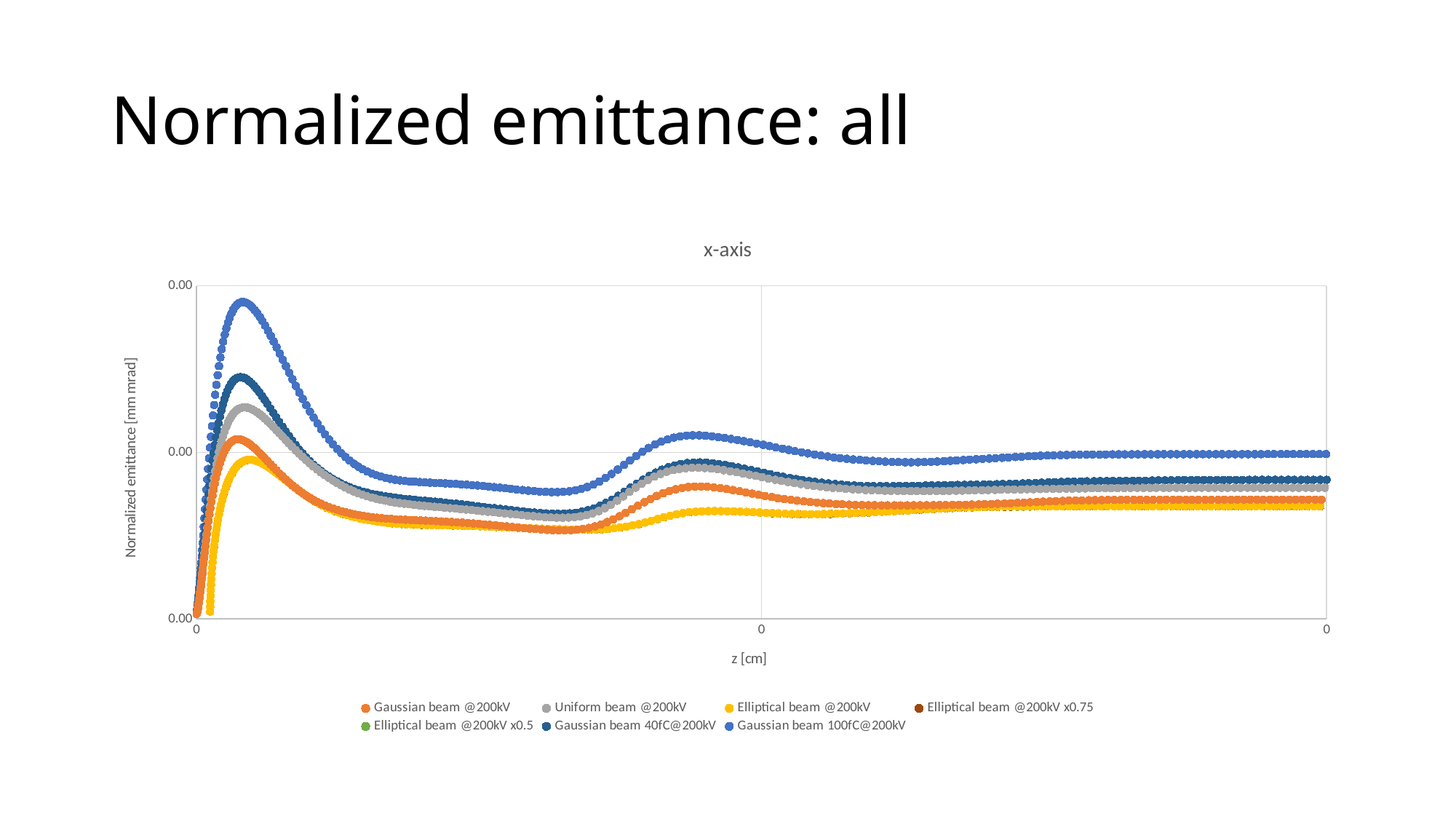
Which series has the higher initial peak, Uniform beam @200kV or Gaussian beam @200kV? Uniform beam @200kV Immediately after its first peak, does the Gaussian beam 100fC@200kV series rise or fall along the z axis? fall What is the label on the chart's vertical axis? Normalized emittance [mm mrad] What is the title of the chart? x-axis What kind of chart is shown on the slide? scatter chart Toward the right-hand end of the z axis, do the series values keep changing strongly or level off? level off Which series lies highest at the right-hand end of the z axis? Gaussian beam 100fC@200kV Which series has the higher initial peak, Gaussian beam 100fC@200kV or Gaussian beam 40fC@200kV? Gaussian beam 100fC@200kV How many series does the chart's legend list? 7 Which series has the lowest initial peak near the start of the z axis? Elliptical beam @200kV Which series reaches the highest peak near the start of the z axis? Gaussian beam 100fC@200kV